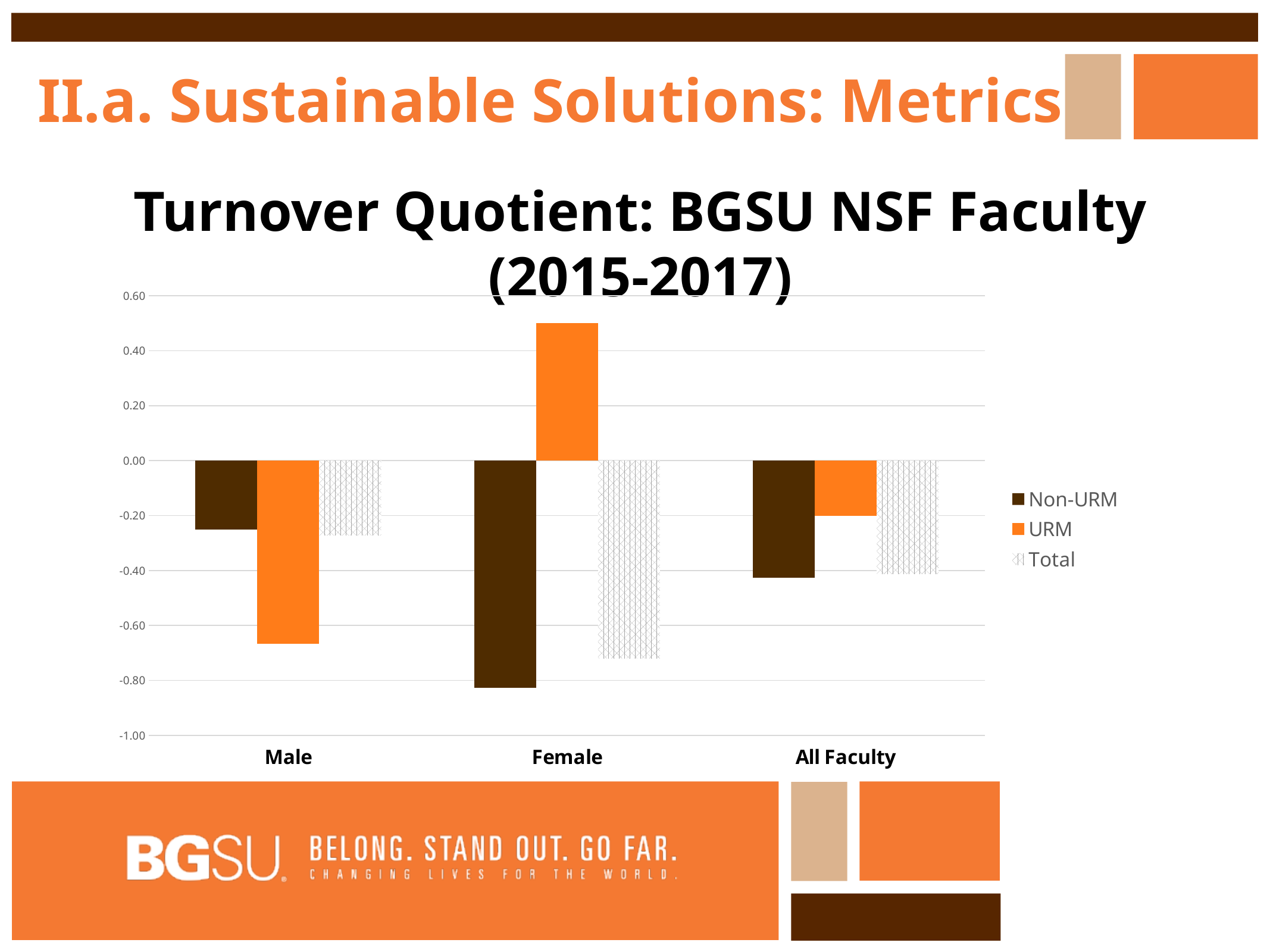
Is the URM value for Female greater or less than 0.40? greater How many categories are shown on the x axis? 3 Is the URM value for All Faculty greater or less than -0.40? greater Which category has the lowest Non-URM value? Female What type of chart is shown on the slide? Bar chart Is the Non-URM value for Female greater or less than -0.60? less For Male, which is larger, the Non-URM value or the URM value? Non-URM How many series does the legend list? 3 Which series are listed in the legend? Non-URM, URM, Total Which category has the highest URM value? Female What is the title of the chart? Turnover Quotient: BGSU NSF Faculty (2015-2017)